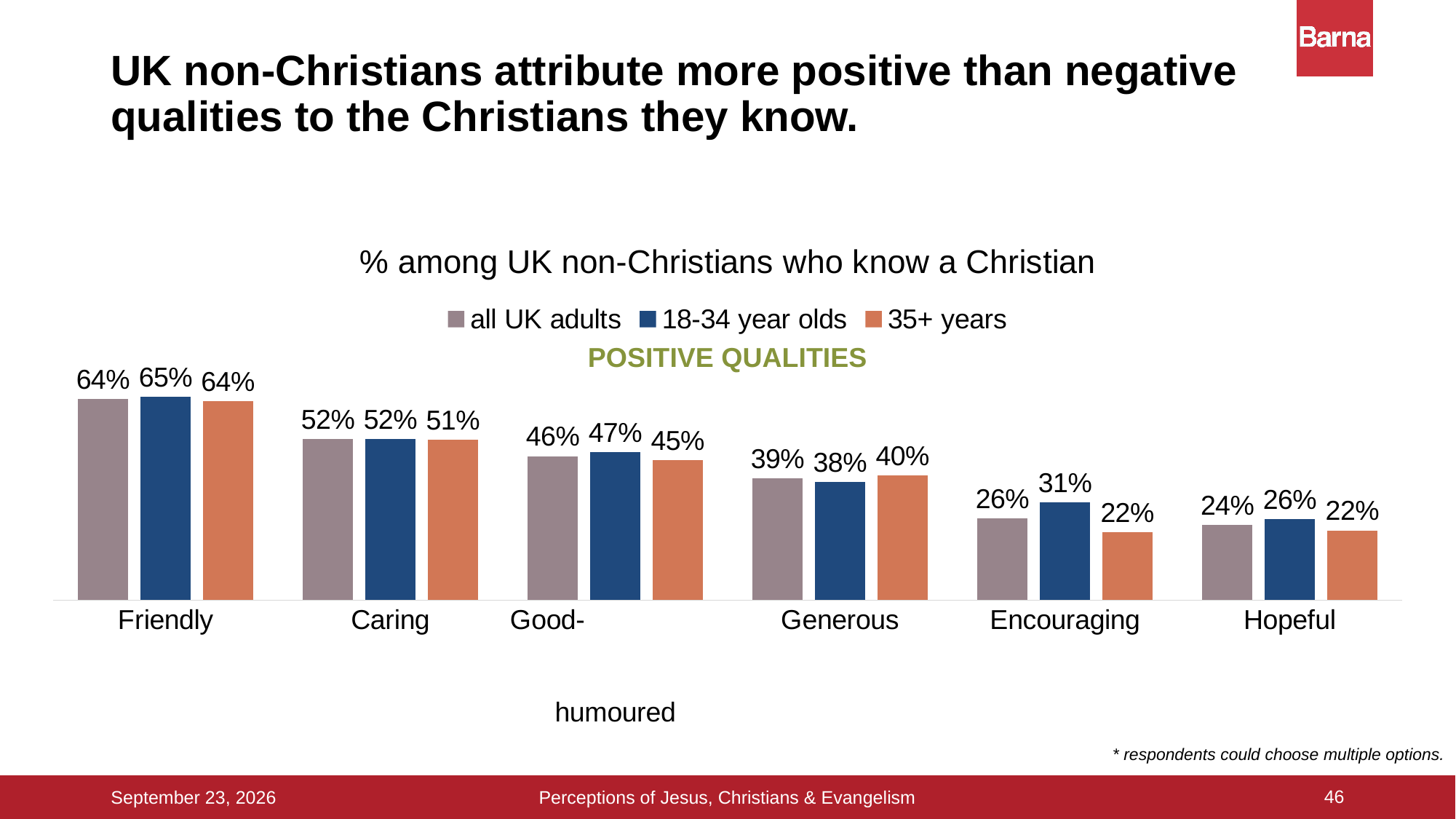
What percentage of all UK adults attribute the quality 'Friendly' to the Christians they know? 64% For 'Good-humoured', which is larger: the value for 18-34 year olds or for 35+ years? 18-34 year olds What is the difference between the 18-34 year olds and 35+ years values for 'Encouraging'? 9 percentage points How many series does the legend list? 3 Which quality has the highest value for all UK adults? Friendly Do the values for all UK adults rise or fall from left to right across the qualities? Fall What is the value for 18-34 year olds for 'Encouraging'? 31% How many qualities are shown on the x axis? 6 What is the chart's title? % among UK non-Christians who know a Christian What kind of chart is shown on the slide? Bar chart What is the value for 35+ years for 'Generous'? 40% Which quality has the lowest value for all UK adults? Hopeful